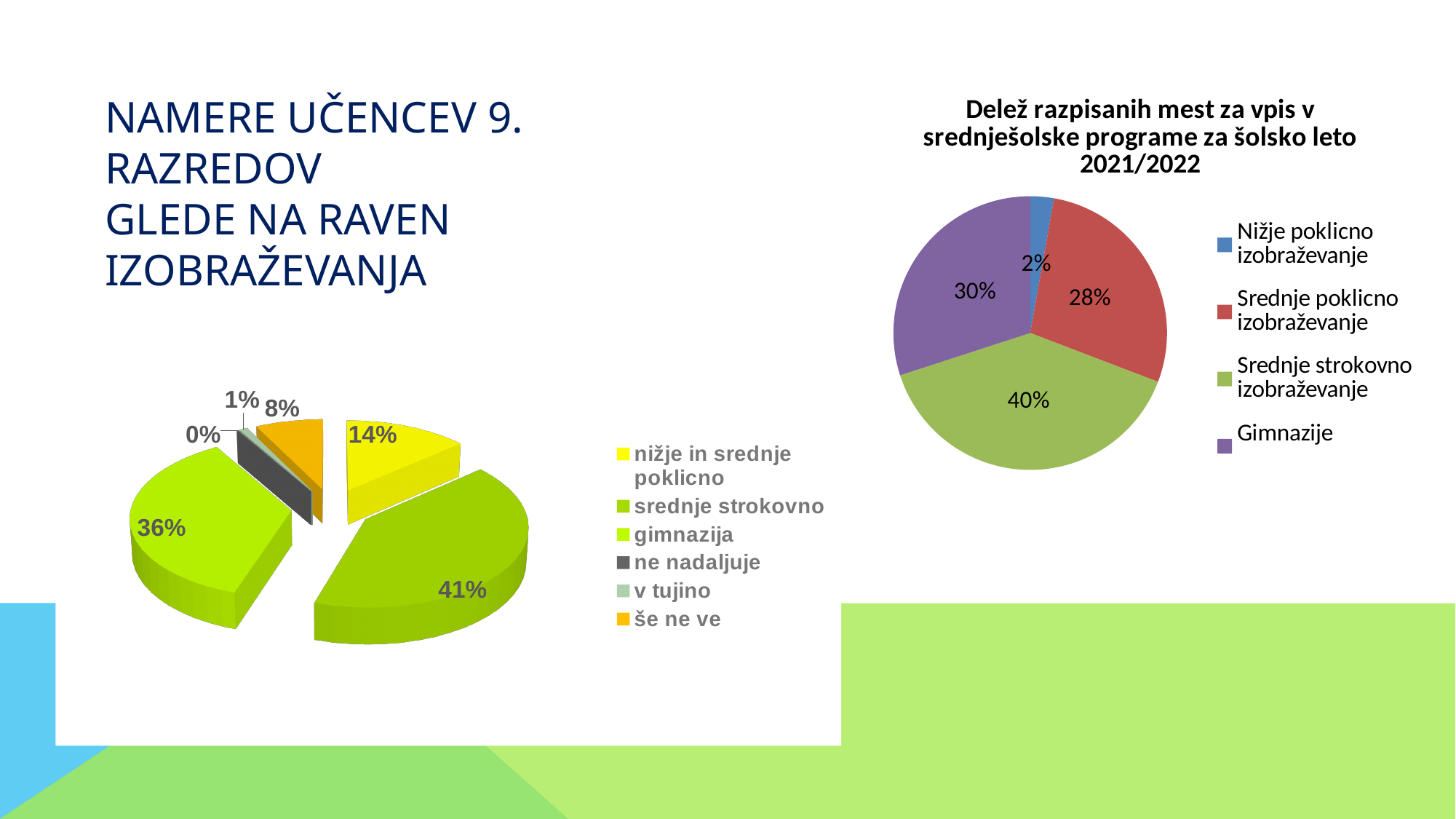
In the chart titled 'Delež razpisanih mest za vpis v srednješolske programe za šolsko leto 2021/2022', what share is shown for 'Srednje poklicno izobraževanje'? 28% In the left pie chart (without a title), what share is shown for 'gimnazija'? 36% In the left pie chart (without a title), how many categories does the legend list? 6 In the chart titled 'Delež razpisanih mest za vpis v srednješolske programe za šolsko leto 2021/2022', what share is shown for 'Gimnazije'? 30% In the left pie chart (without a title), which category has the largest share? srednje strokovno In the left pie chart (without a title), which category has the smallest share? ne nadaljuje In the left pie chart (without a title), what share is shown for 'še ne ve'? 8% In the left pie chart (without a title), what is the difference between the shares for 'srednje strokovno' and 'gimnazija'? 5% In the chart titled 'Delež razpisanih mest za vpis v srednješolske programe za šolsko leto 2021/2022', which category has the smallest share? Nižje poklicno izobraževanje In the chart titled 'Delež razpisanih mest za vpis v srednješolske programe za šolsko leto 2021/2022', which category has the largest share? Srednje strokovno izobraževanje What kind of chart is the chart titled 'Delež razpisanih mest za vpis v srednješolske programe za šolsko leto 2021/2022'? Pie chart In the left pie chart (without a title), what share is shown for 'srednje strokovno'? 41%